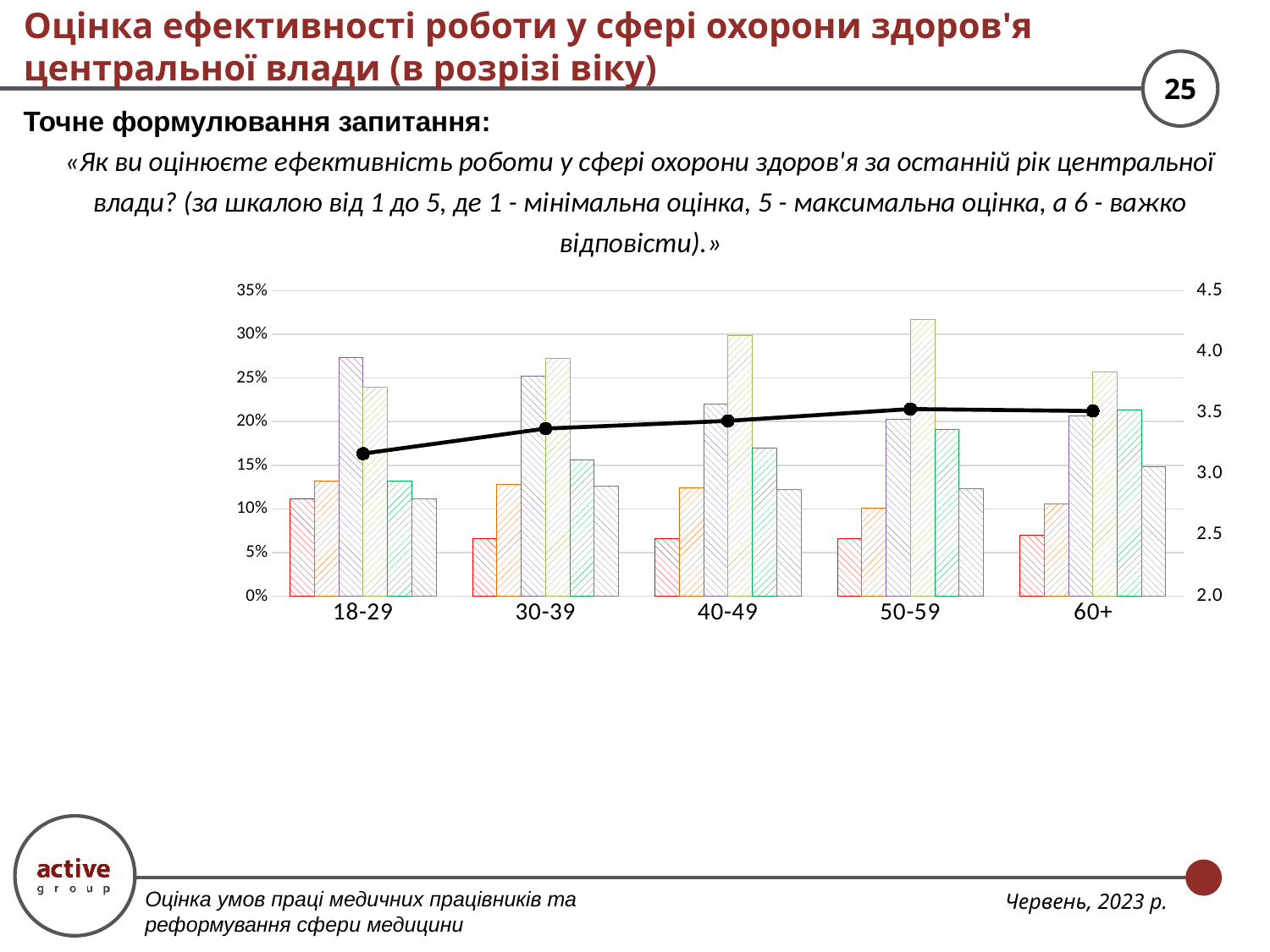
Is the tallest bar in the 50-59 group greater or less than 30%? greater Is the value of the black line for the 50-59 group greater or less than the value for the 18-29 group? greater How many bars are plotted for each age group in the chart? 6 What is the maximum value shown on the left-hand percentage axis of the chart? 35% What kind of chart is shown on the slide? Combined bar and line chart For which age group is the black line at its lowest point? 18-29 Is the value of the black line for the 18-29 group greater or less than 3.5 on the right-hand axis? less Does the black line in the chart generally rise or fall from the 18-29 group to the 60+ group? Rise How many age groups are shown on the x axis of the chart? 5 Is the tallest bar in the 18-29 group greater or less than 30%? less